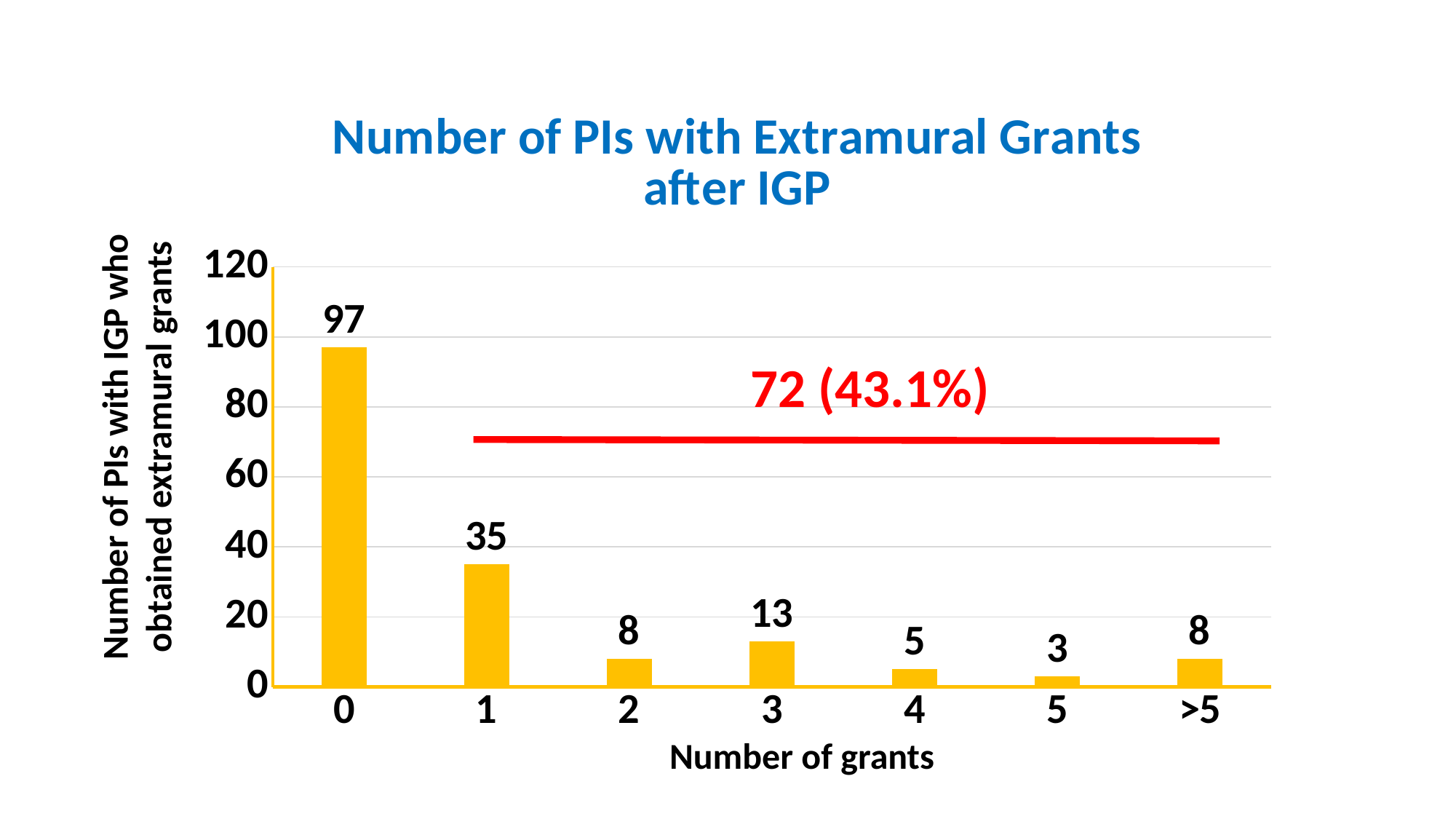
What is the difference between the values for 0 grants and 1 grant? 62 What is the title of the chart? Number of PIs with Extramural Grants after IGP Which category has the lowest value? 5 What is the value for the '0' grants category? 97 How many categories are shown on the x axis? 7 Is the value for 1 grant greater or less than 40? less How many PIs obtained 1 extramural grant? 35 What kind of chart is this? bar chart What is the value for the '3' grants category? 13 Which category has the highest value? 0 Which is larger, the value for 3 grants or the value for 4 grants? 3 grants What is the value for the '>5' grants category? 8